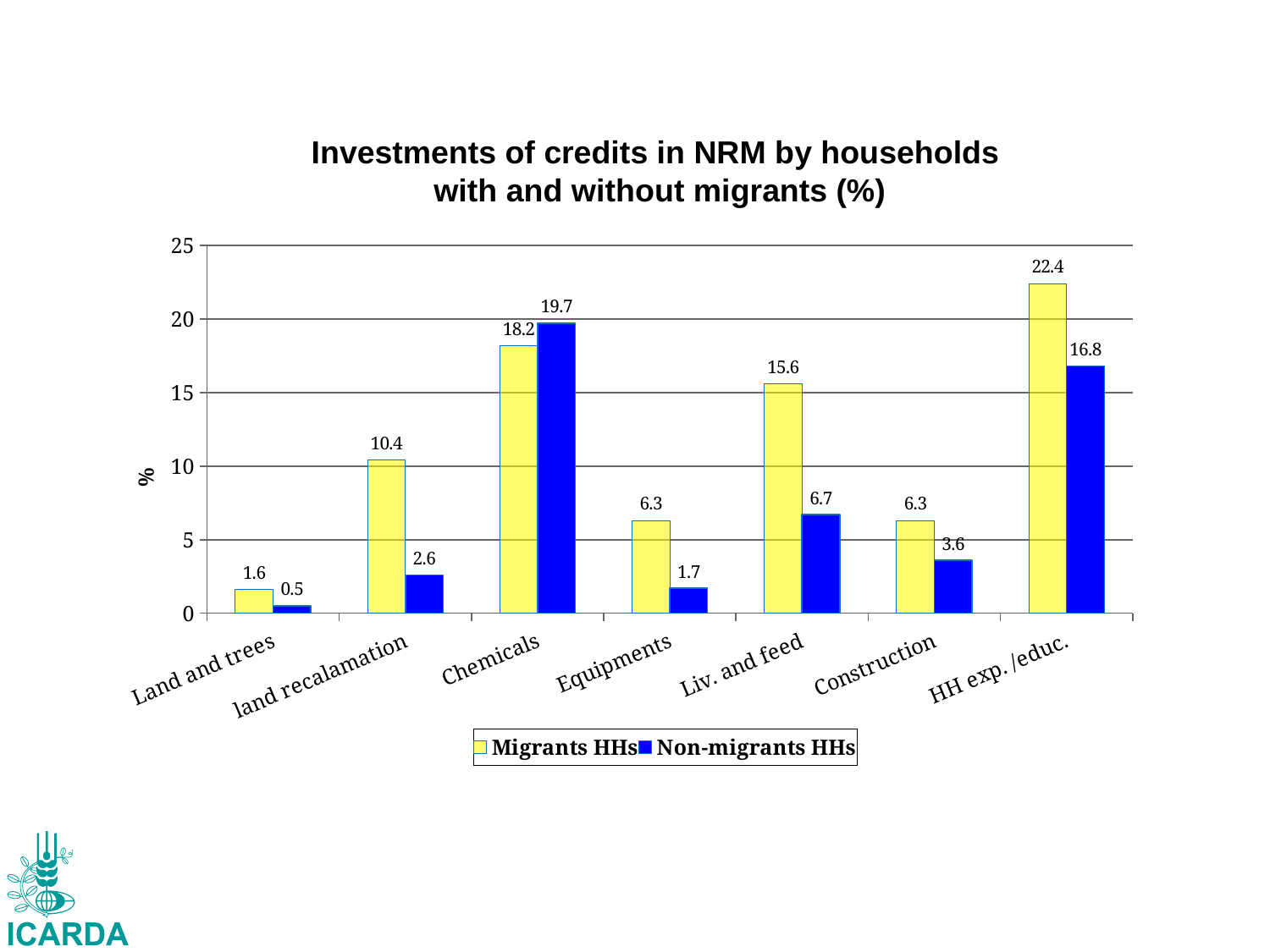
What is the label of the y axis? % What is the difference between Migrants HHs and Non-migrants HHs in the land recalamation category? 7.8 What is the difference between Migrants HHs and Non-migrants HHs in the HH exp./educ. category? 5.6 Which category has the highest value for Migrants HHs? HH exp./educ. What is the value for Non-migrants HHs in the Construction category? 3.6 Is the value for Non-migrants HHs in the Liv. and feed category greater or less than 10? less Which is larger in the Chemicals category, Migrants HHs or Non-migrants HHs? Non-migrants HHs What kind of chart is shown on the slide? bar chart What is the value for Migrants HHs in the Chemicals category? 18.2 How many series does the legend list? 2 Which category has the lowest value for Non-migrants HHs? Land and trees How many categories are shown on the x axis? 7